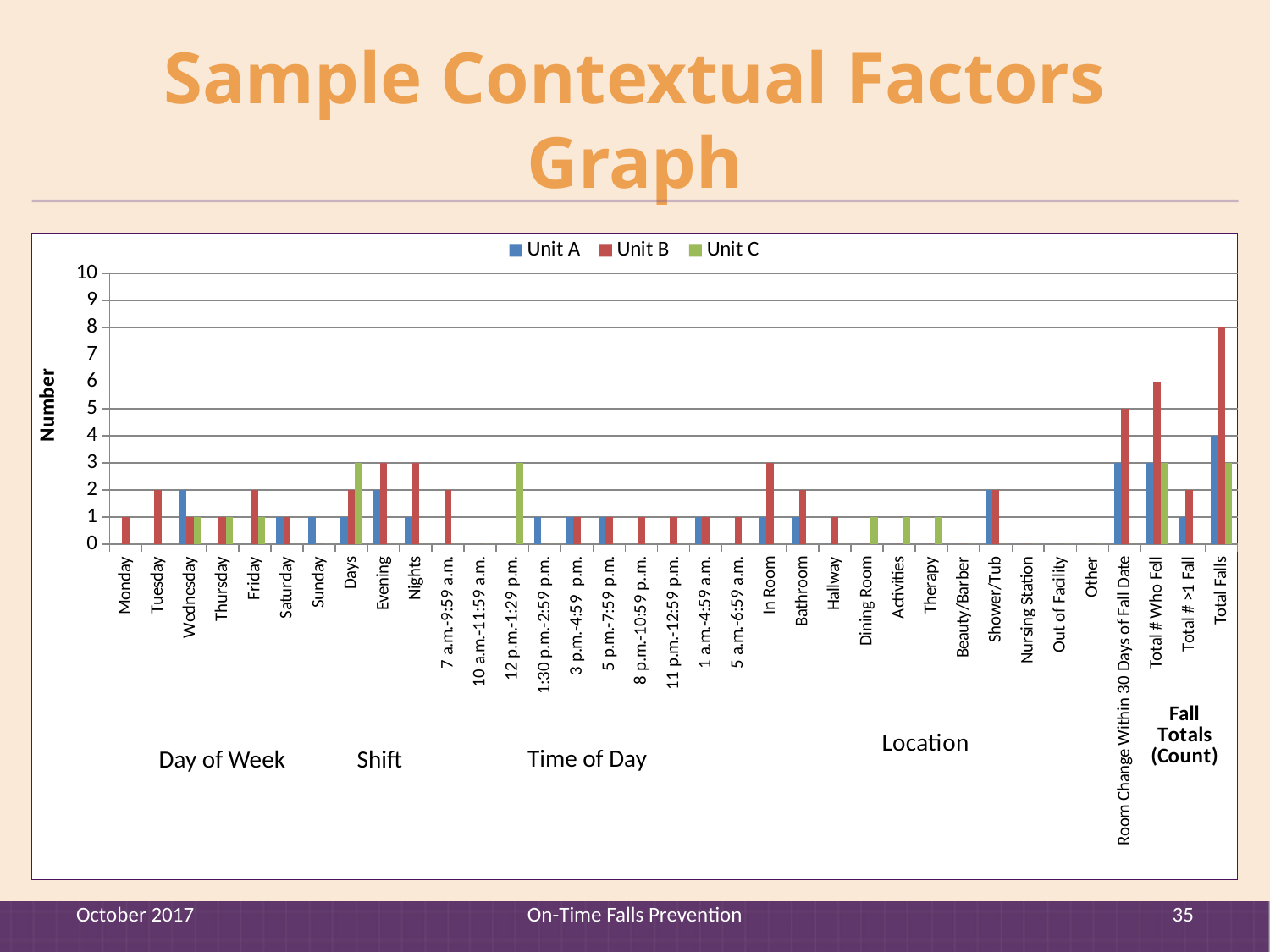
What is the Unit A value for Total Falls? 4 What is the difference between the Unit B and Unit A values for Total Falls? 4 What is the Unit C value for Days? 3 How many series does the legend list? 3 What is the Unit B value for Total Falls? 8 What is the label of the vertical axis? Number Which unit has the highest value for Total # Who Fell? Unit B What kind of chart is shown on the slide? Bar chart Is the Unit B value for In Room larger than the Unit A value for In Room? Yes Is the Unit B value for Total Falls greater or less than 6? greater What is the Unit B value for Room Change Within 30 Days of Fall Date? 5 Which series is shown in green in the legend? Unit C